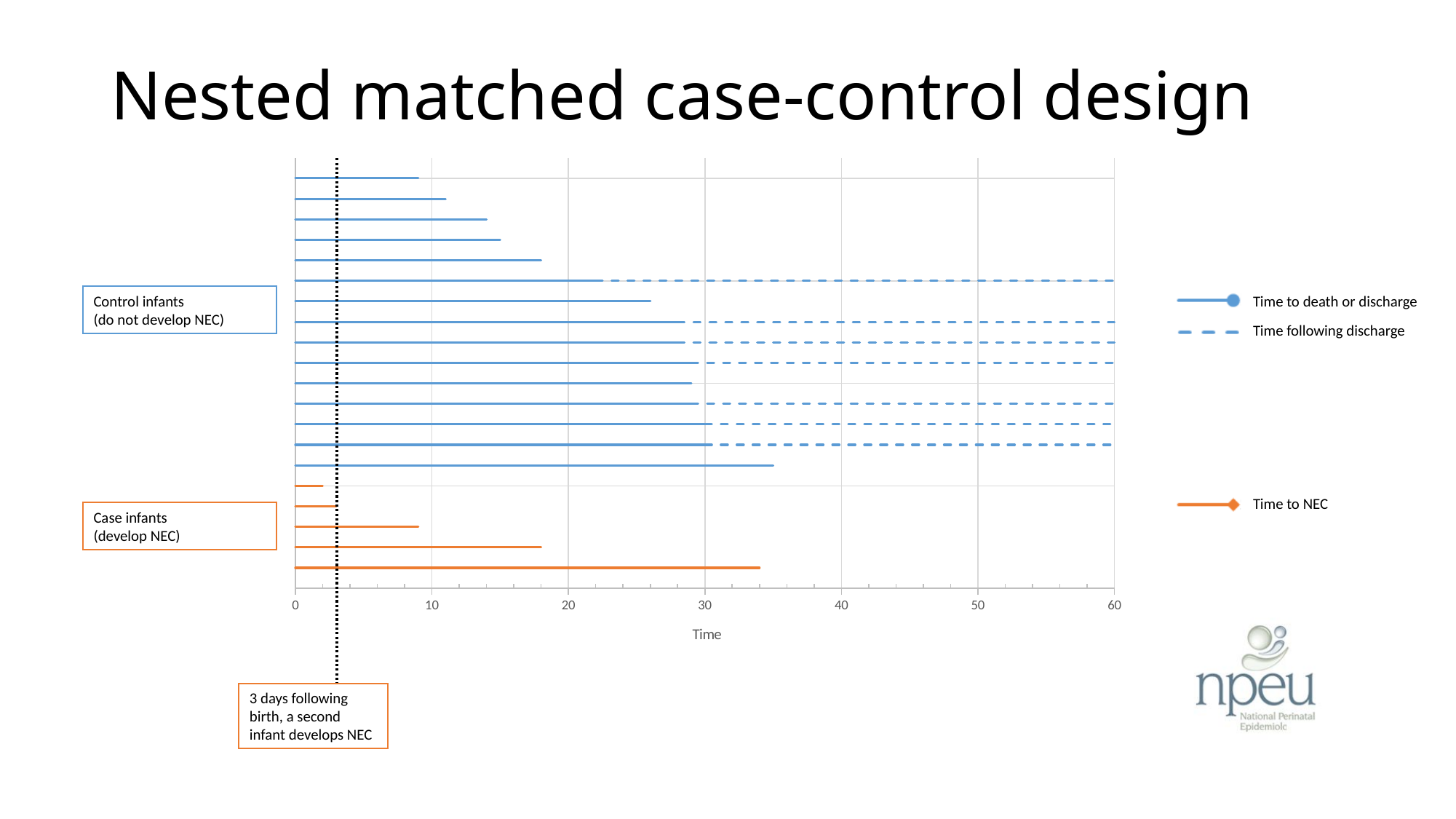
Which legend entry is shown with a dashed line? Time following discharge Is the shortest blue 'Time to death or discharge' bar greater or less than 10? less Is the shortest orange 'Time to NEC' bar greater or less than 10? less Is the longest orange 'Time to NEC' bar greater or less than 30? greater How many blue bars (control infants) are plotted? 15 How many orange bars (case infants) are plotted? 5 How many bars have a dashed 'Time following discharge' segment? 7 How many entries does the legend list? 3 What kind of chart is shown on the slide? line chart At what value on the x axis do the dashed 'Time following discharge' lines end? 60 What is the label of the x axis? Time